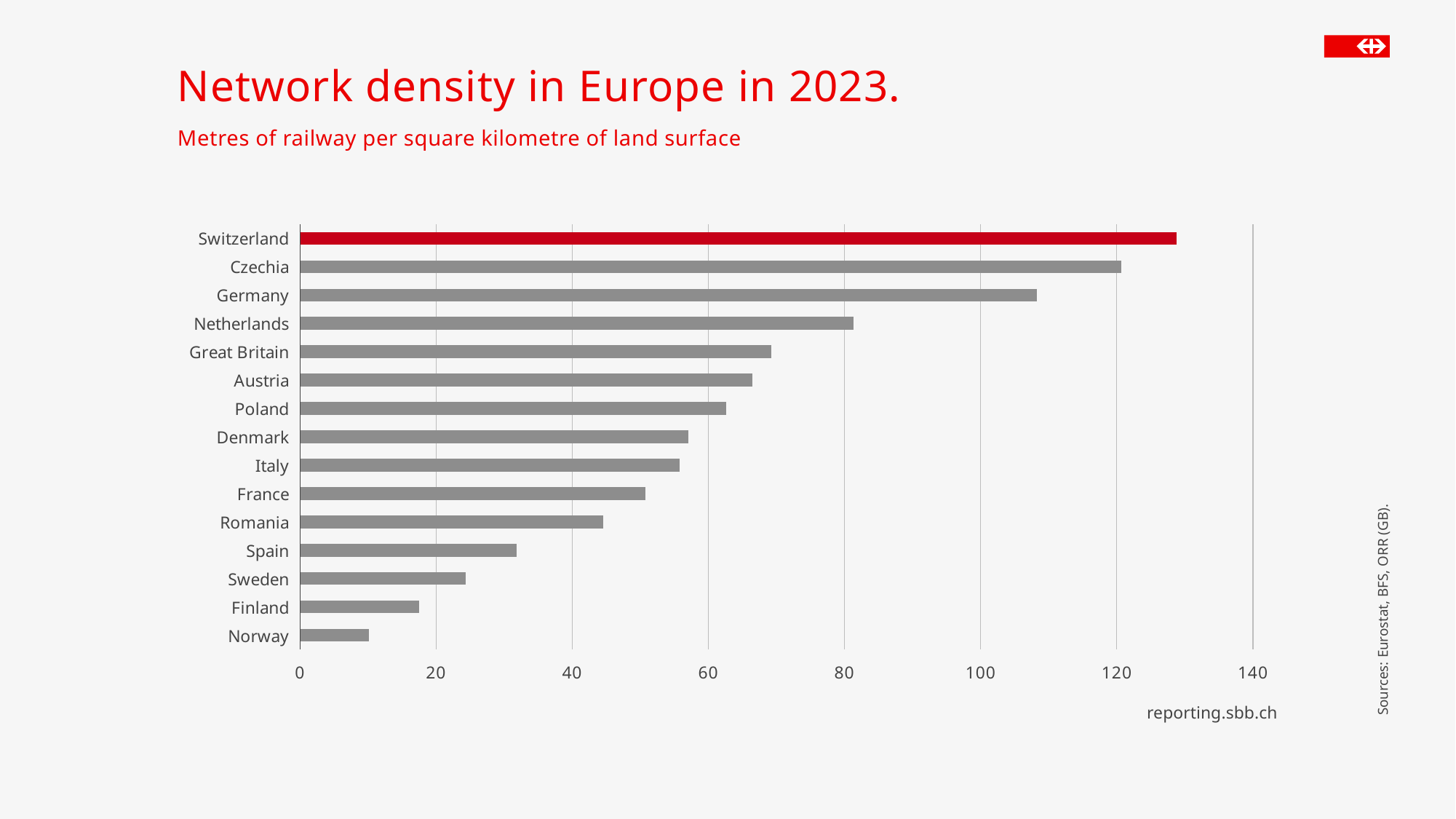
Which has a higher network density, Spain or Romania? Romania Is the value for Norway greater or less than 20? less Which country has the highest network density in the chart? Switzerland Are the bars ordered from highest to lowest or from lowest to highest going down the chart? highest to lowest Is the value for Netherlands greater or less than 100? less Which has a higher network density, Germany or the Netherlands? Germany Which country's bar is highlighted in red? Switzerland What kind of chart is shown on the slide? bar chart How many countries are shown in the chart? 15 Is the value for Germany greater or less than 100? greater Which country has the lowest network density in the chart? Norway